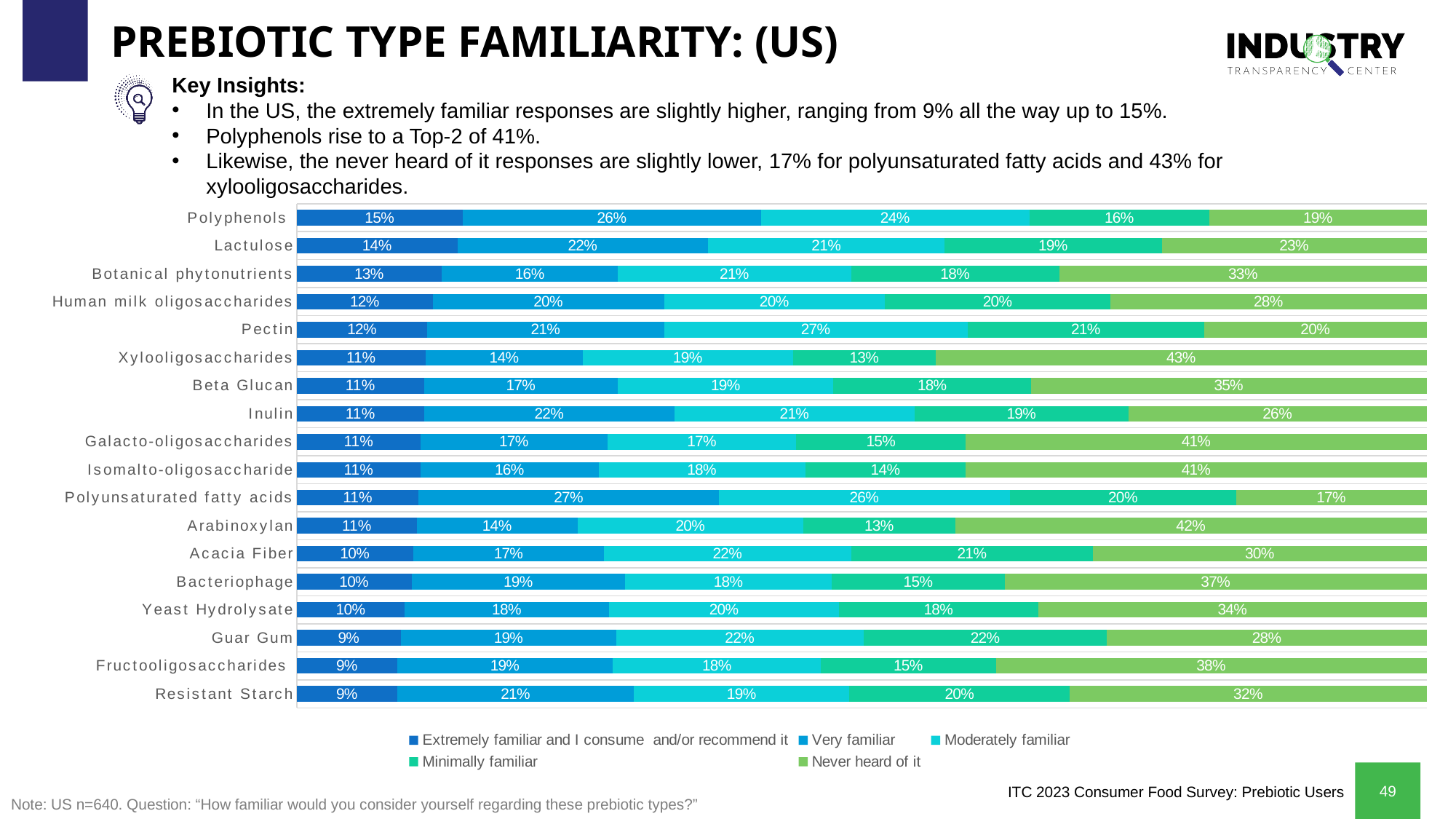
What is the 'Moderately familiar' value for Pectin? 27% Which has a larger 'Minimally familiar' value, Guar Gum or Bacteriophage? Guar Gum Which prebiotic type has the highest 'Extremely familiar and I consume and/or recommend it' value? Polyphenols What is the combined value of 'Extremely familiar and I consume and/or recommend it' and 'Very familiar' for Polyphenols? 41% What is the 'Never heard of it' value for Xylooligosaccharides? 43% What is the 'Very familiar' value for Polyunsaturated fatty acids? 27% How many prebiotic types are plotted on the chart? 18 What is the difference between the 'Never heard of it' values for Xylooligosaccharides and Polyphenols? 24% How many series does the legend list? 5 Which colour represents the 'Never heard of it' series in the legend? Light green What kind of chart is shown on the slide? Stacked bar chart Which prebiotic type has the lowest 'Never heard of it' value? Polyunsaturated fatty acids